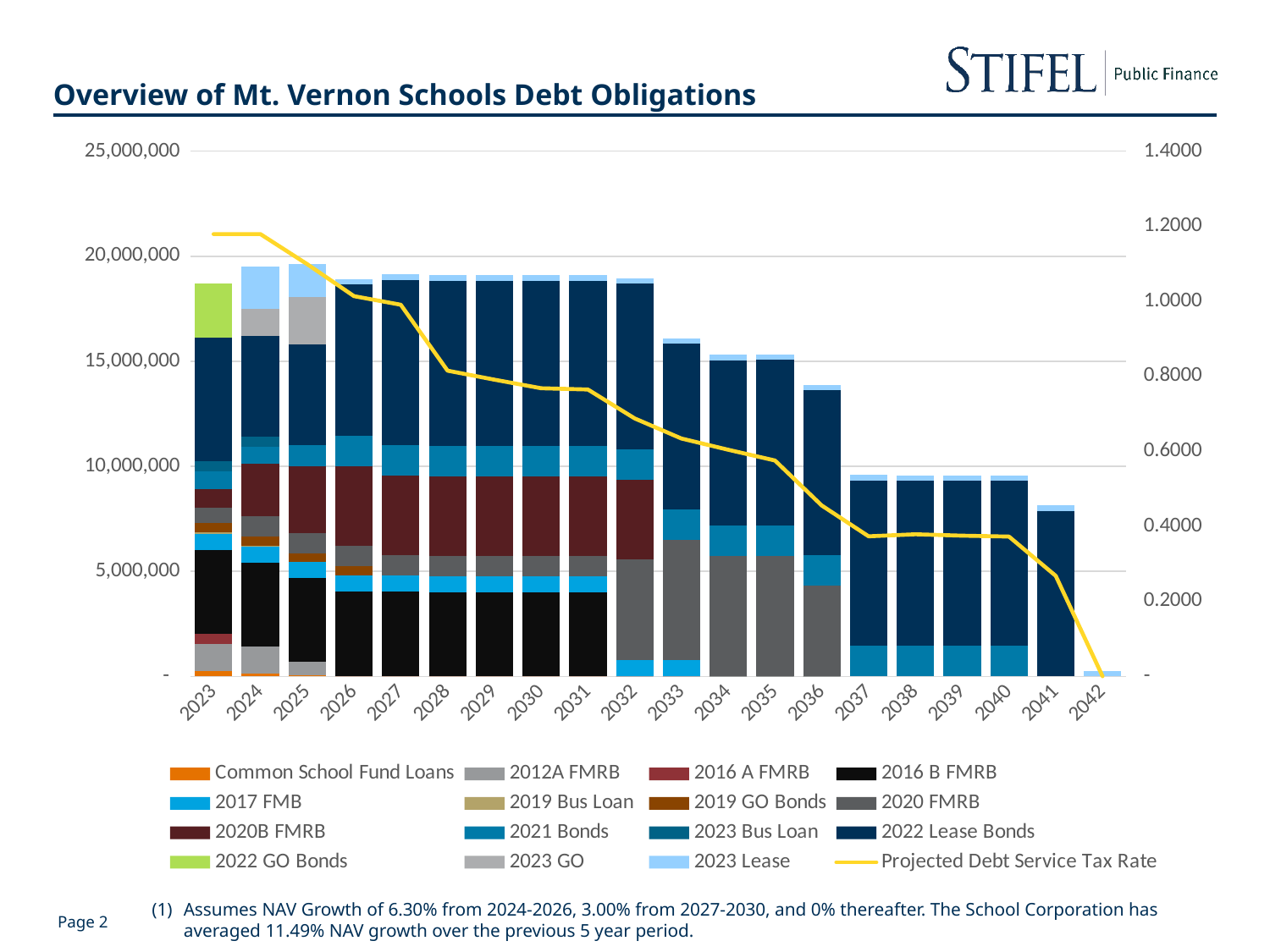
Is the Projected Debt Service Tax Rate for 2042 greater or less than 0.2000? less Which year has the lowest total debt obligation bar? 2042 Is the total debt obligation bar for 2041 greater or less than 10,000,000? less How many years are shown along the x axis of the chart? 20 What kind of chart is shown on the slide? Stacked bar chart with a line Is the total debt obligation bar for 2042 greater or less than 5,000,000? less Which year has the larger total debt obligation bar, 2033 or 2037? 2033 What is the title of the chart on the slide? Overview of Mt. Vernon Schools Debt Obligations Does the Projected Debt Service Tax Rate line generally rise or fall from 2023 to 2042? fall How many entries does the chart's legend list? 16